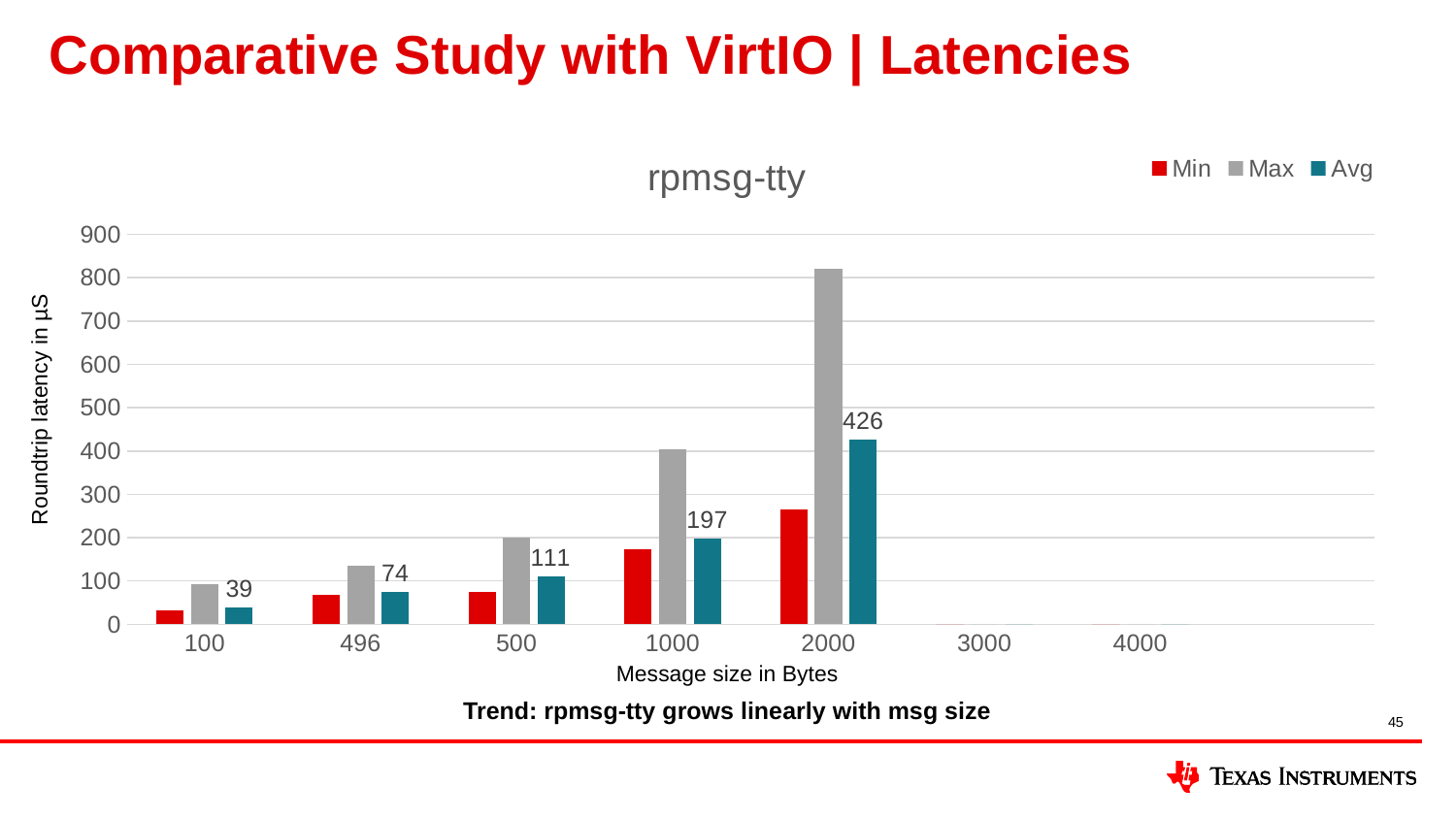
What is the difference between the Avg latency at 2000 bytes and at 1000 bytes? 229 What is the Avg value for a message size of 1000 bytes? 197 Is the Max latency for a message size of 2000 bytes greater or less than 800? greater Which is larger at a message size of 500 bytes, the Max latency or the Avg latency? Max What is the Avg roundtrip latency for a message size of 100 bytes? 39 Which message size has the highest Avg roundtrip latency? 2000 What kind of chart is shown on the slide? Bar chart How many series does the legend list? 3 What is the Avg roundtrip latency for a message size of 2000 bytes? 426 What is the Avg value for a message size of 496 bytes? 74 Is the Min latency for a message size of 1000 bytes greater or less than 200? less